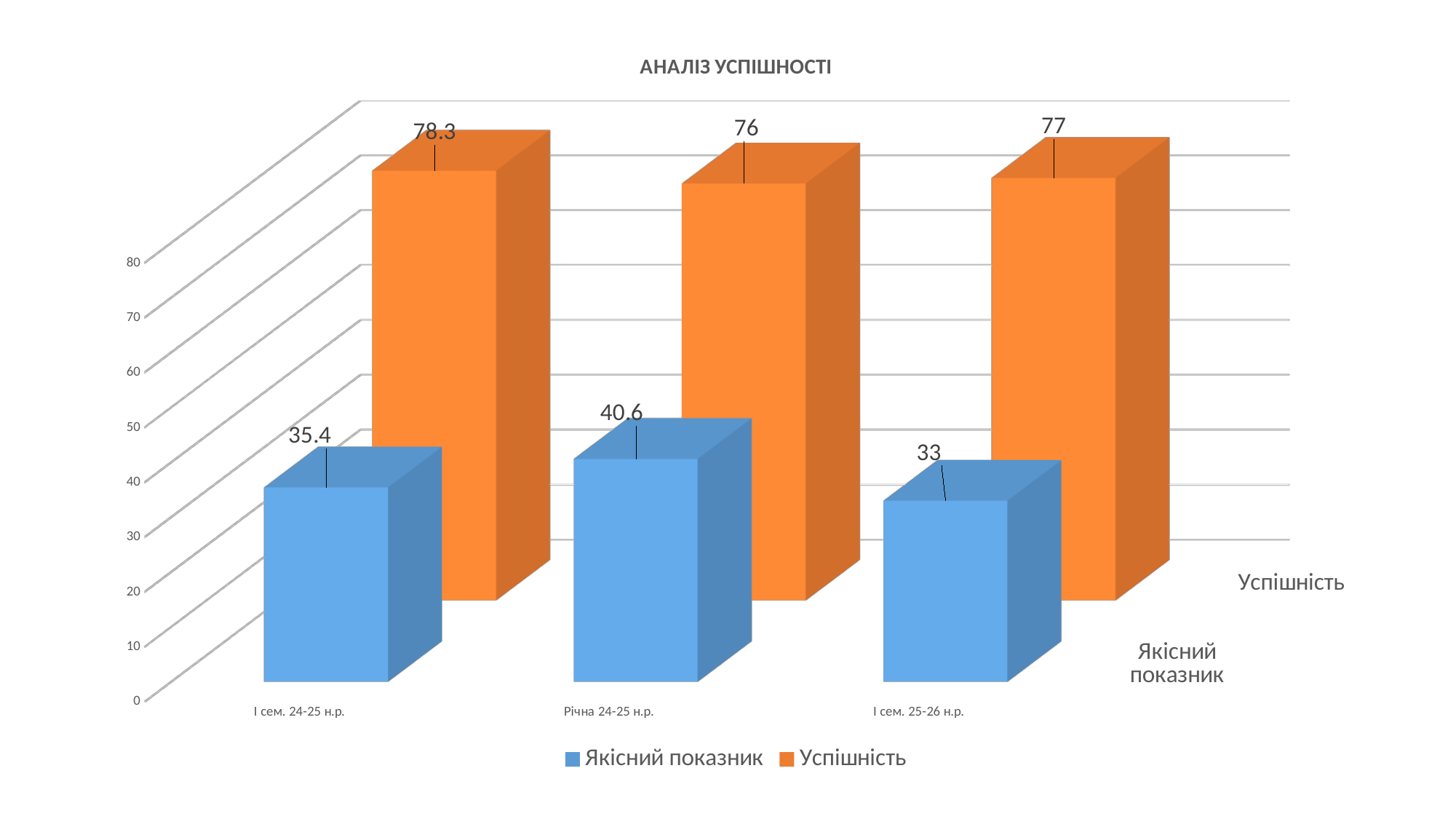
How many series does the legend list? 2 Which category has the highest Якісний показник value? Річна 24-25 н.р. What is the value of Успішність for Річна 24-25 н.р.? 76 Which series is shown in orange? Успішність What is the title of the chart? АНАЛІЗ УСПІШНОСТІ What type of chart is shown on the slide? Bar chart What is the value of Якісний показник for І сем. 24-25 н.р.? 35.4 How many categories are shown on the x axis? 3 What is the difference between Успішність and Якісний показник for І сем. 25-26 н.р.? 44 Which category has the lowest Успішність value? Річна 24-25 н.р. What is the value of Якісний показник for І сем. 25-26 н.р.? 33 Which is larger: Успішність for І сем. 24-25 н.р. or Успішність for І сем. 25-26 н.р.? І сем. 24-25 н.р.